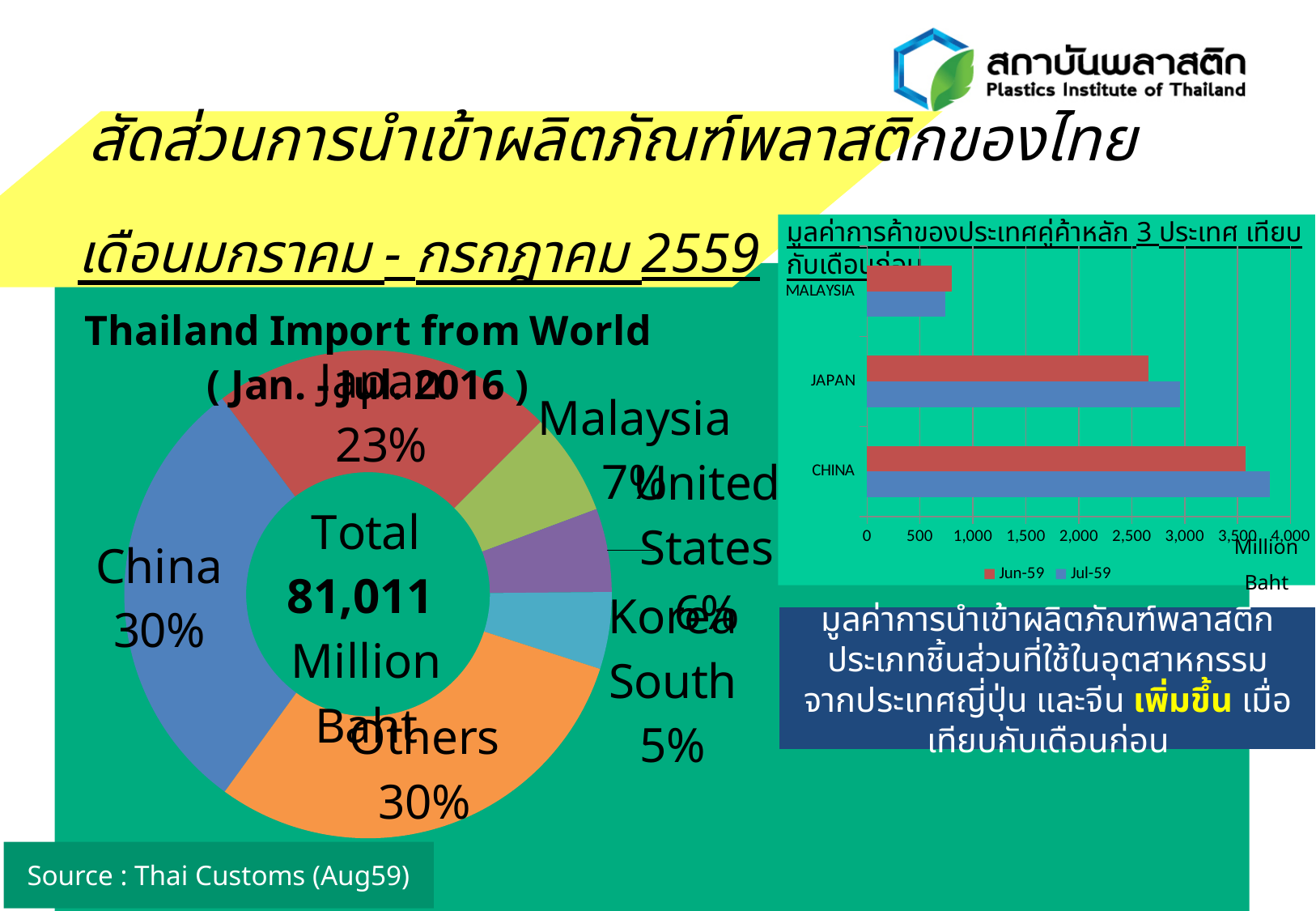
In the donut chart 'Thailand Import from World (Jan. - Jul. 2016)', what total value is shown in the centre? 81,011 Million Baht In the donut chart 'Thailand Import from World (Jan. - Jul. 2016)', what share does China have? 30% In the donut chart 'Thailand Import from World (Jan. - Jul. 2016)', how many categories are shown? 6 In the donut chart 'Thailand Import from World (Jan. - Jul. 2016)', which category has the smallest share? Korea South In the bar chart on the right of the slide, which is larger for JAPAN, the Jun-59 value or the Jul-59 value? Jul-59 In the donut chart 'Thailand Import from World (Jan. - Jul. 2016)', what share does Japan have? 23% In the bar chart on the right of the slide, is the Jul-59 value for CHINA greater or less than 3,500? greater In the donut chart 'Thailand Import from World (Jan. - Jul. 2016)', what is the difference in percentage points between China's share and Japan's share? 7 percentage points In the donut chart 'Thailand Import from World (Jan. - Jul. 2016)', what share does Malaysia have? 7% In the donut chart 'Thailand Import from World (Jan. - Jul. 2016)', which is larger, the share of Japan or the share of Malaysia? Japan In the bar chart on the right of the slide, is the Jun-59 value for JAPAN greater or less than 3,000? less In the bar chart on the right of the slide, how many series does the legend list? 2